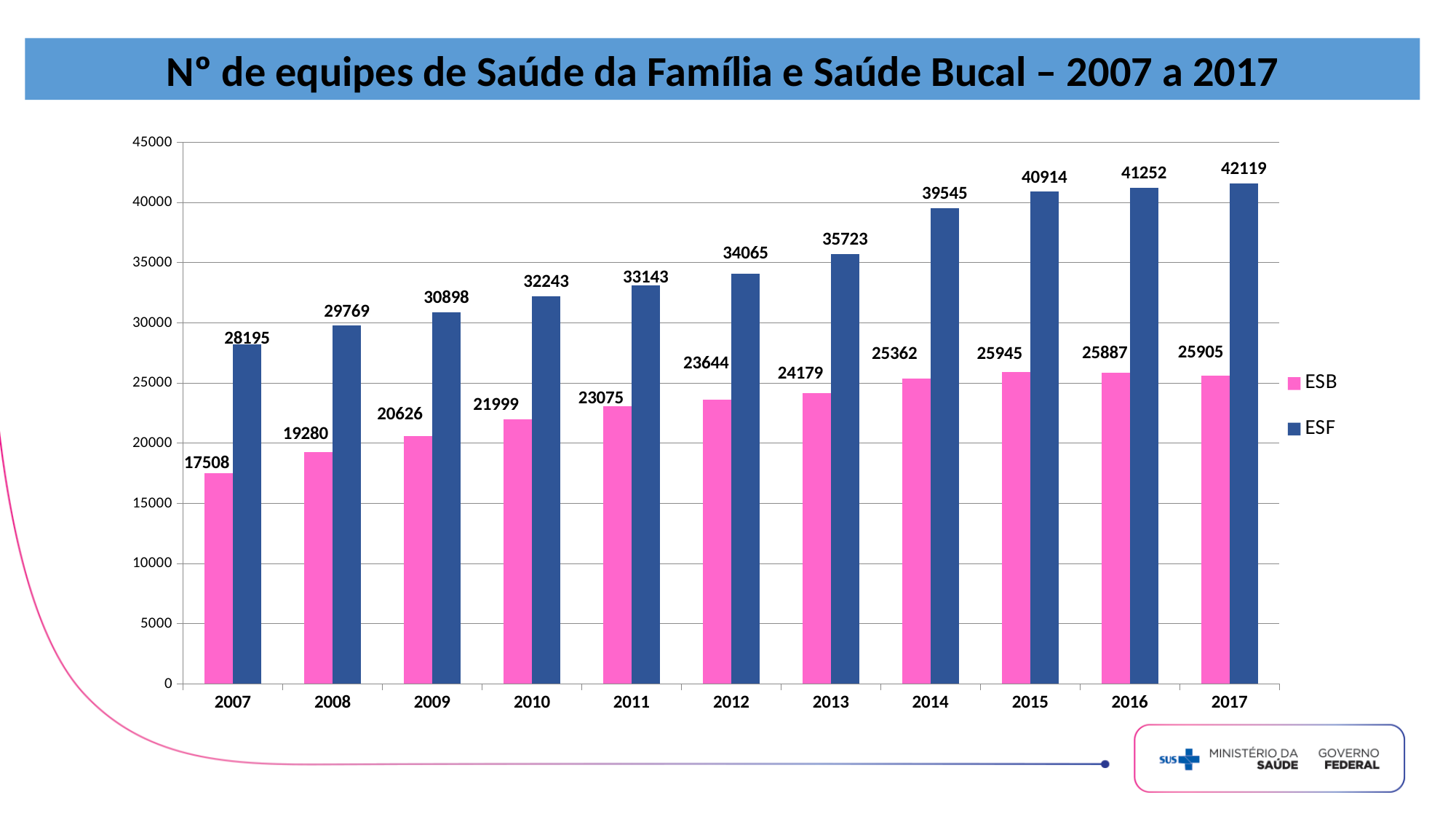
In which year is the ESF value lowest? 2007 What is the value for ESF in 2017? 42119 In which year is the ESB value highest? 2015 Do the ESF values rise or fall from 2007 to 2017? rise What is the difference between the ESF and ESB values in 2017? 16214 What is the value for ESF in 2012? 34065 How many series does the legend list? 2 Is the ESB value for 2012 greater or less than 20000? greater How many years are shown on the x axis? 11 What is the difference between the ESF values for 2014 and 2013? 3822 What is the value for ESB in 2007? 17508